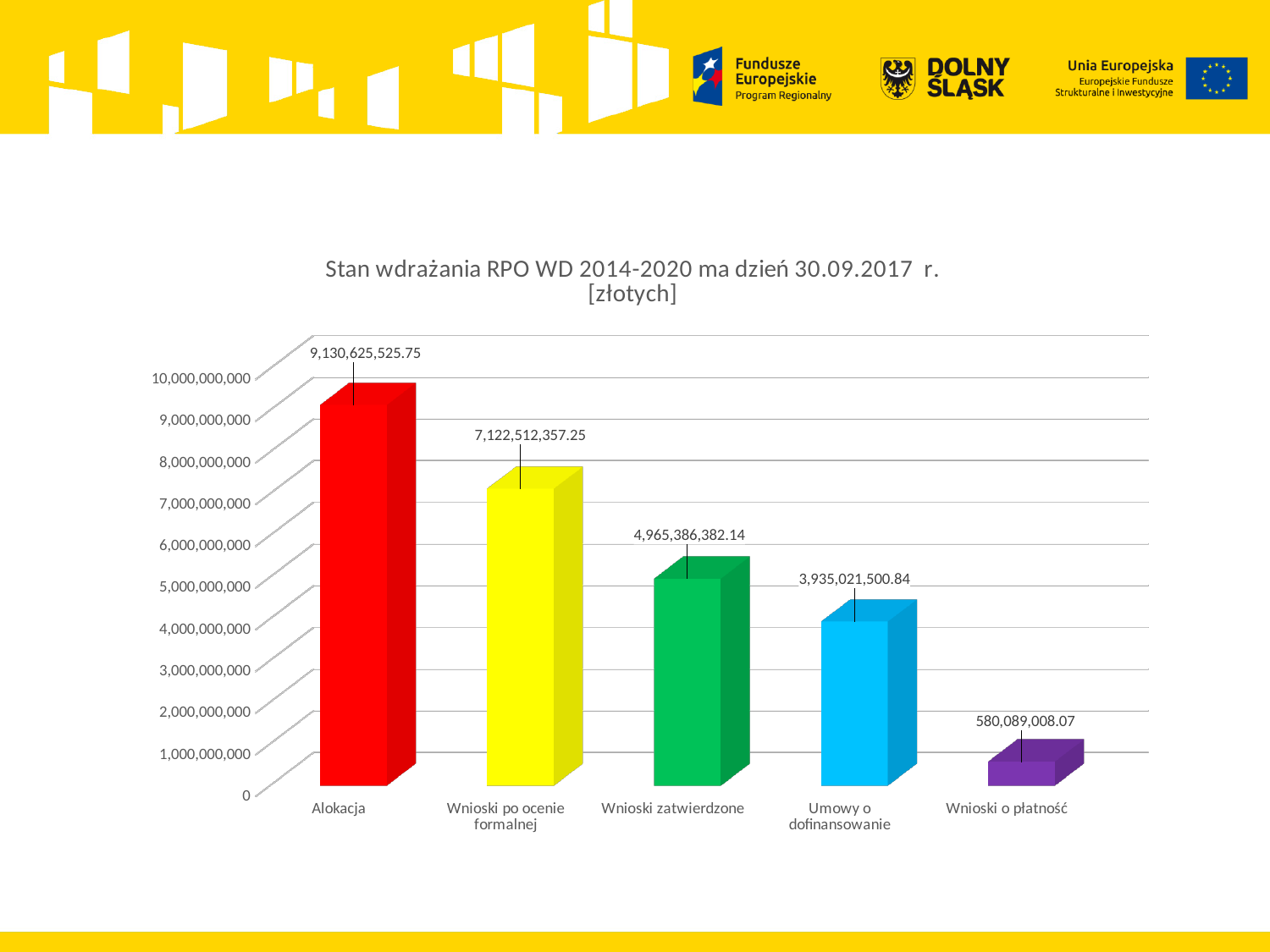
What is the difference between the values for Alokacja and Wnioski po ocenie formalnej? 2,008,113,168.50 What is the value for Wnioski po ocenie formalnej? 7,122,512,357.25 What is the value for Alokacja? 9,130,625,525.75 What is the value for Wnioski o płatność? 580,089,008.07 What is the value for Umowy o dofinansowanie? 3,935,021,500.84 Which is larger, the value for Wnioski zatwierdzone or the value for Umowy o dofinansowanie? Wnioski zatwierdzone What kind of chart is shown on the slide? Bar chart What is the value for Wnioski zatwierdzone? 4,965,386,382.14 How many categories are shown on the x axis? 5 Which category has the highest value? Alokacja Which category has the lowest value? Wnioski o płatność Do the values rise or fall from left to right along the x axis? Fall